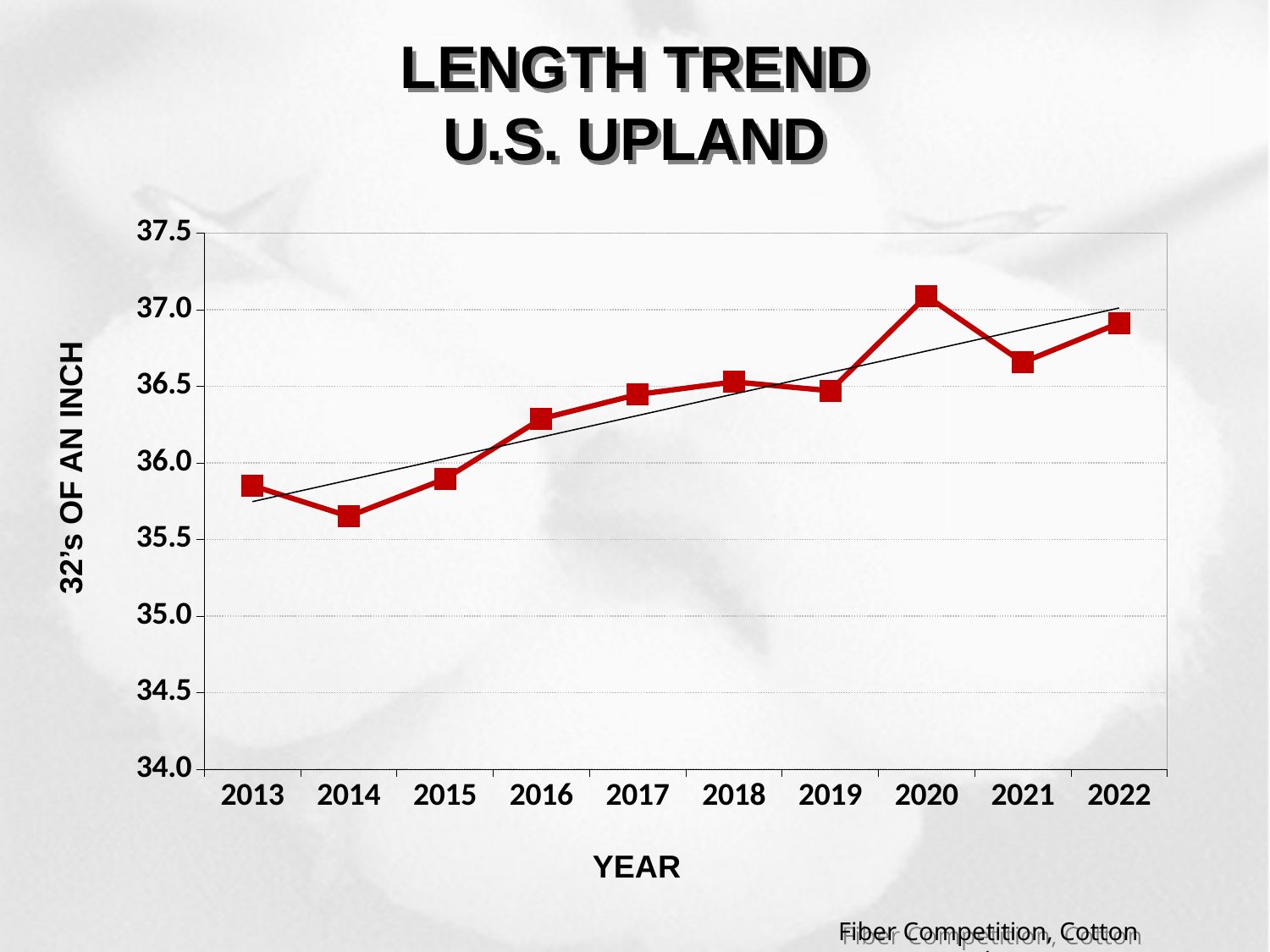
Is the value for 2016 greater or less than 36.0? greater How many years are plotted on the x axis? 10 Which year has the lowest length value? 2014 What is the label on the y axis of the chart? 32's OF AN INCH What kind of chart is shown on the slide? line chart Which year has the highest length value? 2020 Do the length values generally rise or fall from 2013 to 2022? rise Which year has the larger value, 2014 or 2016? 2016 Which year has the larger value, 2020 or 2021? 2020 Is the value for 2020 greater or less than 37.0? greater Is the value for 2014 greater or less than 36.0? less